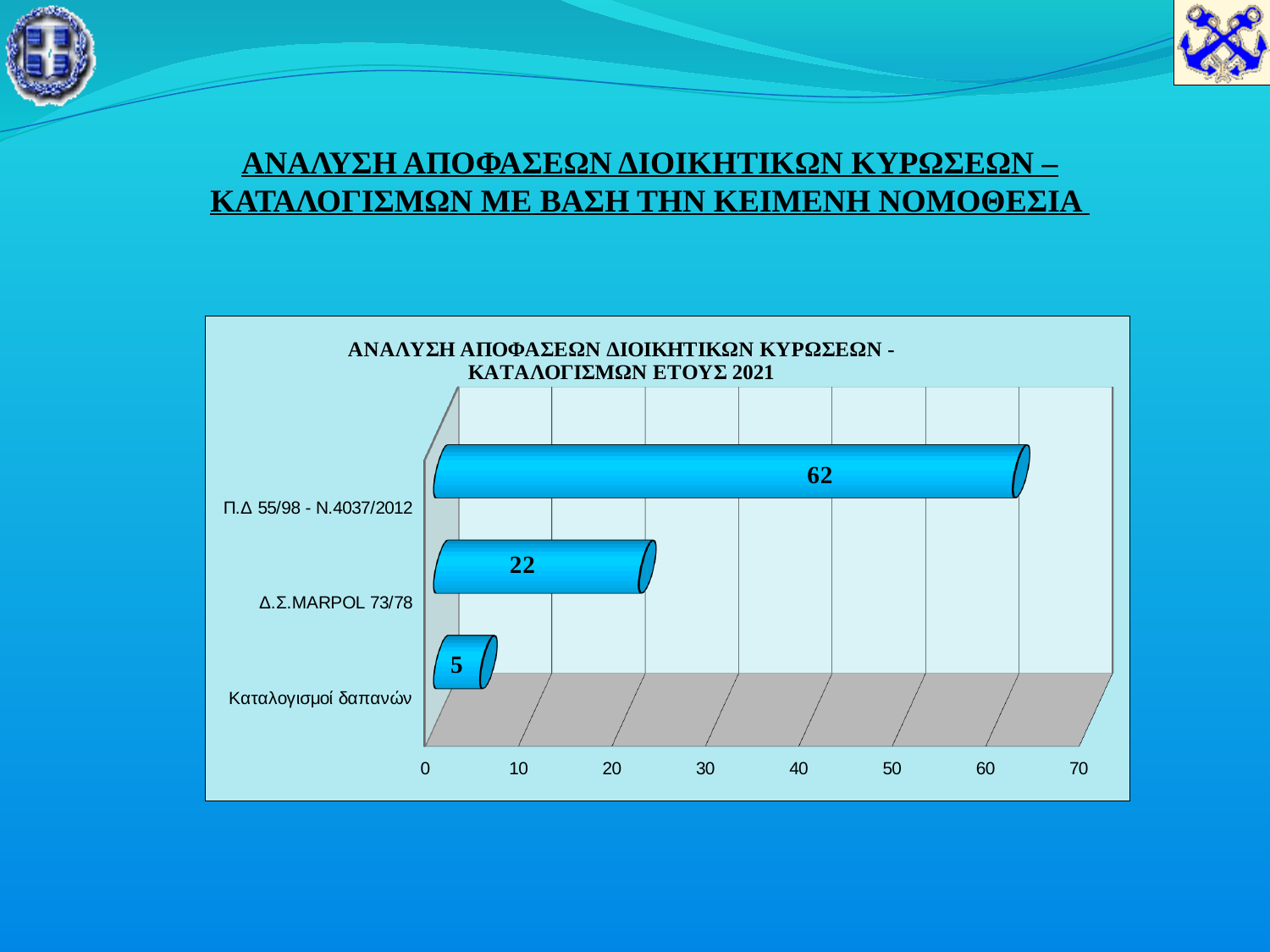
What is the difference between the values for Π.Δ 55/98 - Ν.4037/2012 and Δ.Σ.MARPOL 73/78? 40 Is the value for Π.Δ 55/98 - Ν.4037/2012 greater or less than 50? greater What kind of chart is shown on the slide? bar chart What is the value for Καταλογισμοί δαπανών? 5 Which is larger, the value for Δ.Σ.MARPOL 73/78 or the value for Καταλογισμοί δαπανών? Δ.Σ.MARPOL 73/78 What is the difference between the values for Δ.Σ.MARPOL 73/78 and Καταλογισμοί δαπανών? 17 Which category has the lowest value? Καταλογισμοί δαπανών How many categories are shown in the chart? 3 Which category has the highest value? Π.Δ 55/98 - Ν.4037/2012 What is the value for Π.Δ 55/98 - Ν.4037/2012? 62 What is the value for Δ.Σ.MARPOL 73/78? 22 What year does the chart title refer to? 2021